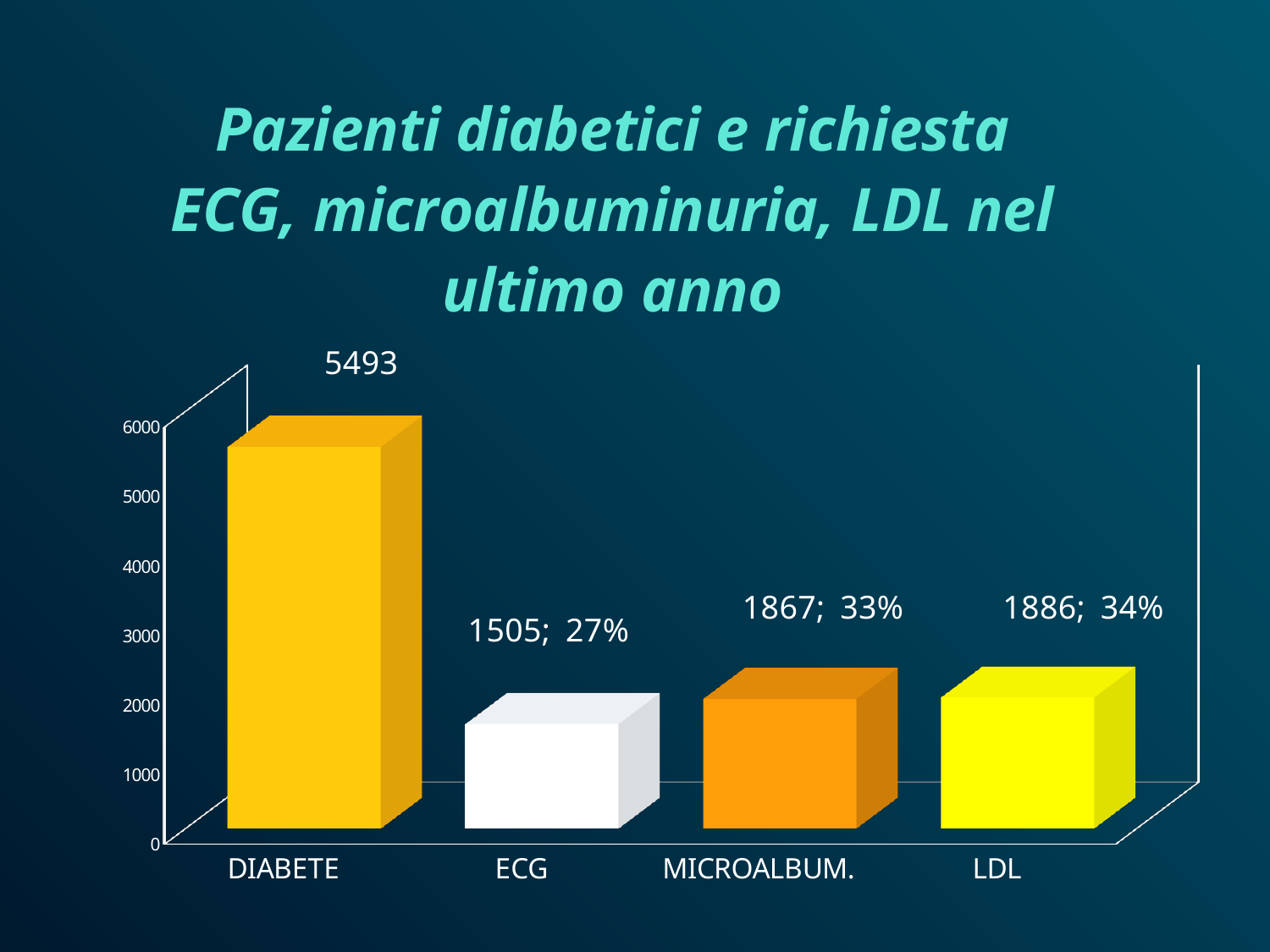
What is the value for LDL? 1886 What is the value for ECG? 1505 How many categories are shown on the x axis? 4 What is the value for DIABETE? 5493 What is the difference between the values for LDL and MICROALBUM.? 19 What kind of chart is shown on the slide? bar chart Which category has the lowest value? ECG What is the difference between the values for DIABETE and ECG? 3988 What percentage is shown for MICROALBUM.? 33% Which category has the highest value? DIABETE Is the value for DIABETE greater or less than 5000? greater Which is larger, the value for ECG or the value for MICROALBUM.? MICROALBUM.